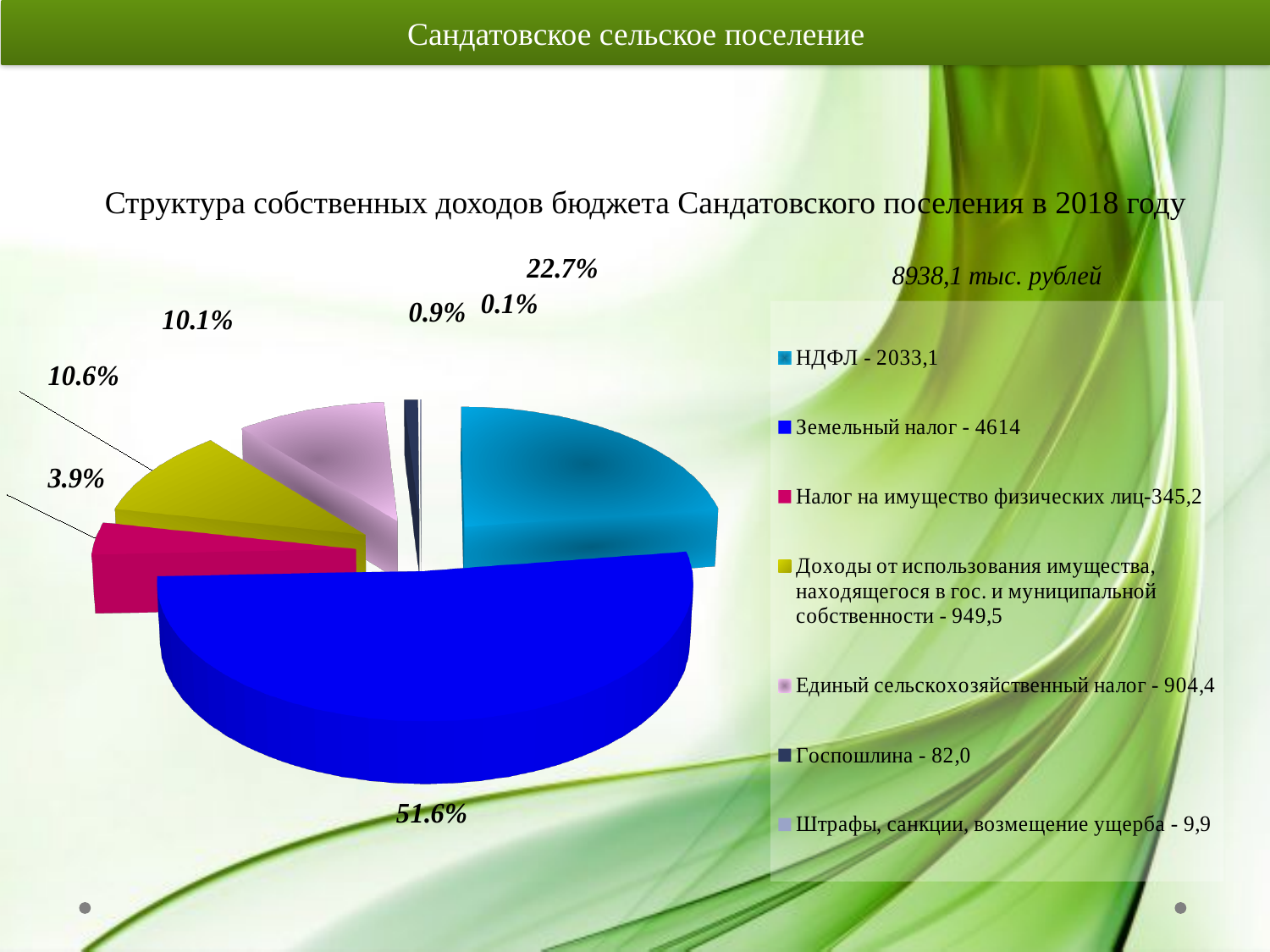
What is the difference in percentage points between the Земельный налог share and the НДФЛ share? 28.9 Which category has the largest slice of the pie? Земельный налог What type of chart is shown on the slide? pie chart Which category has the smallest slice of the pie? Штрафы, санкции, возмещение ущерба What value is shown in the legend for Единый сельскохозяйственный налог? 904,4 Which is larger, the share for НДФЛ or the share for Единый сельскохозяйственный налог? НДФЛ What share of the pie does Налог на имущество физических лиц take? 3.9% What is the title of the chart? 8938,1 тыс. рублей How many categories does the legend list? 7 What share of the pie does НДФЛ take? 22.7% What share of the pie does Земельный налог take? 51.6% What value is shown in the legend for Госпошлина? 82,0